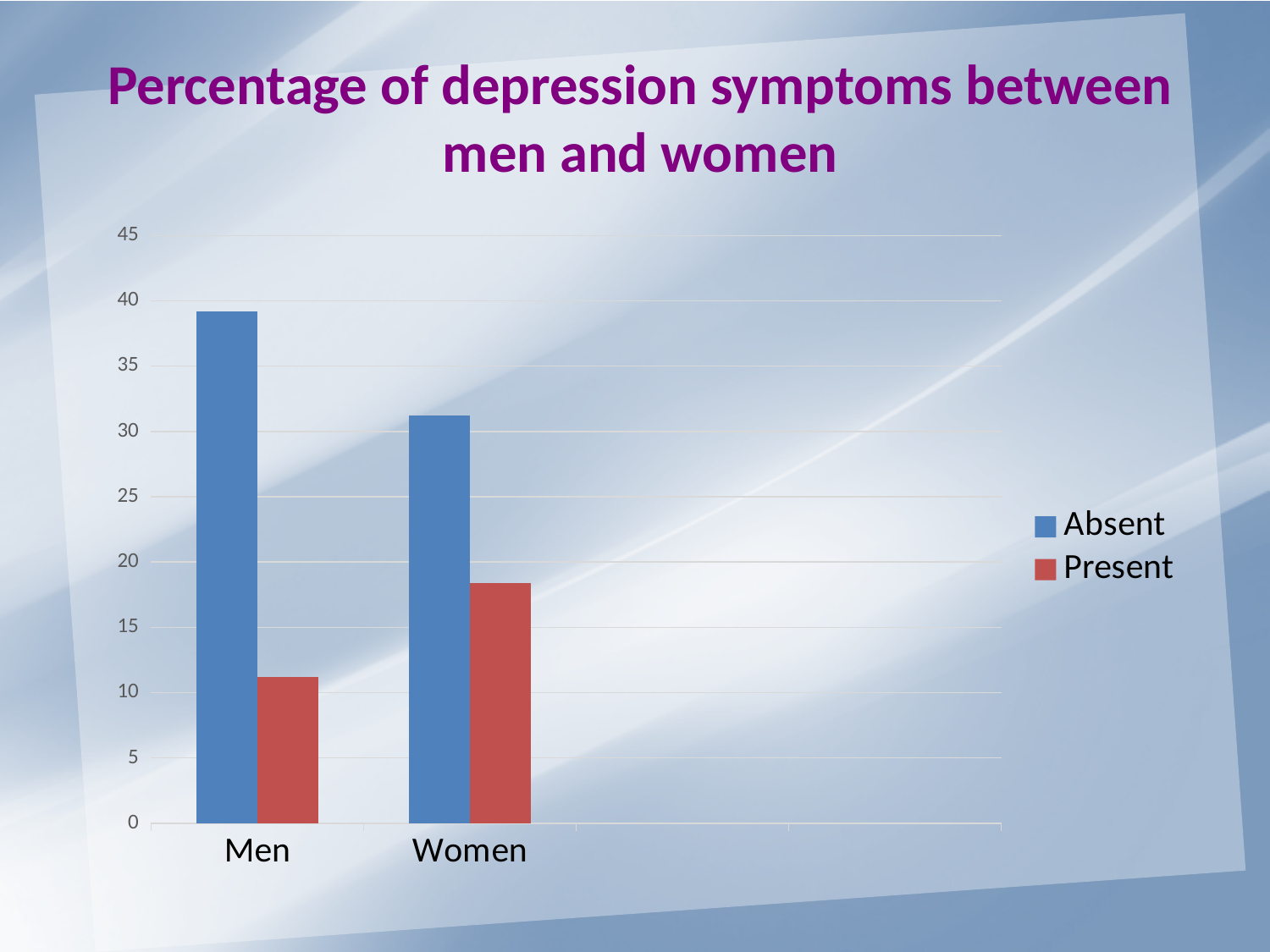
How many series does the legend list? 2 What is the title of the chart? Percentage of depression symptoms between men and women Is the Present value for Men greater or less than 15? less Is the Present value for Women greater or less than 20? less Which bar is the tallest in the chart? Absent for Men How many categories are shown on the x axis? 2 Which category has the higher Absent value, Men or Women? Men Is the Absent value for Men greater or less than 35? greater Which series is shown in blue? Absent What kind of chart is shown on the slide? bar chart Which category has the higher Present value, Men or Women? Women